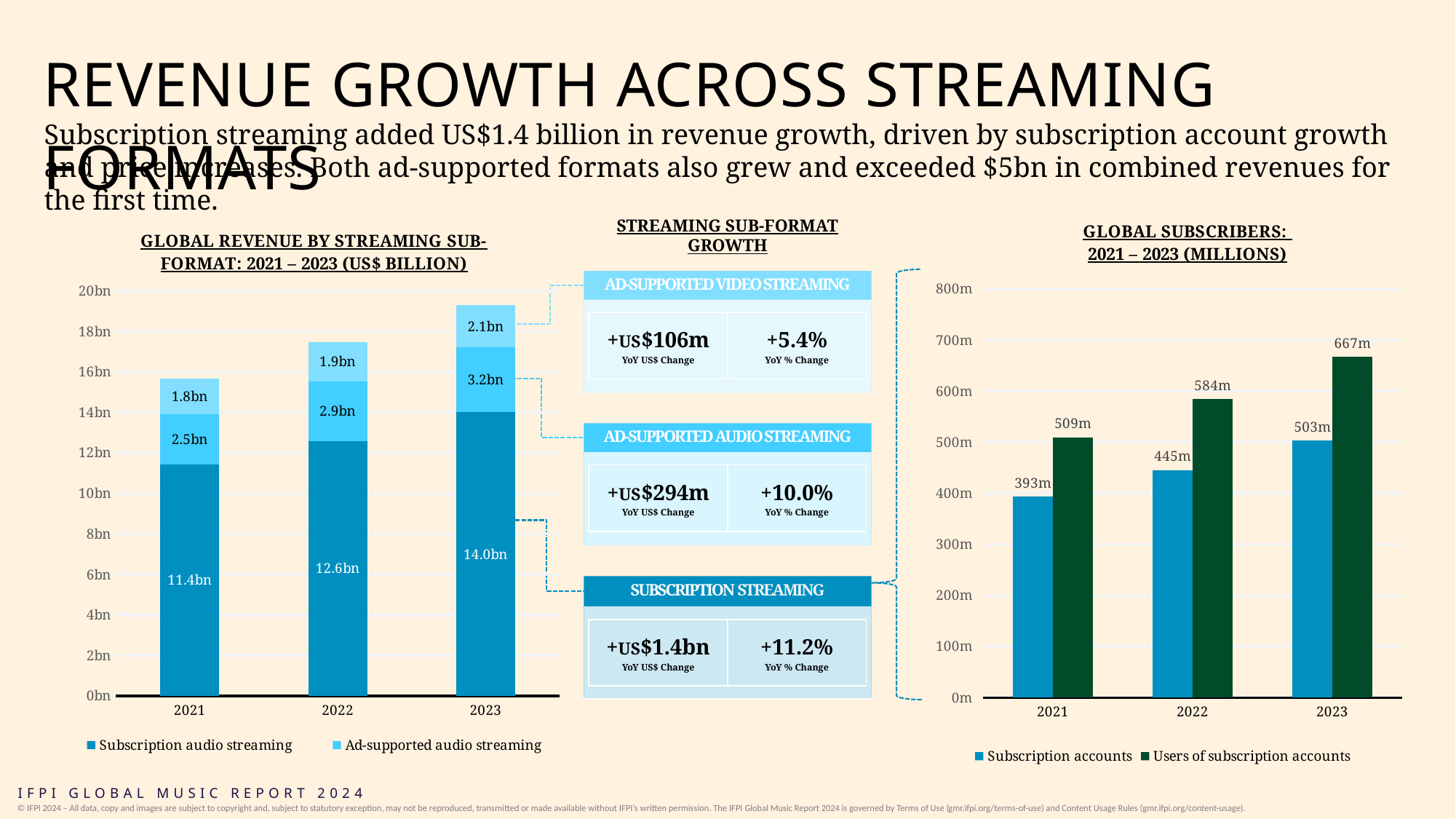
What kind of chart is the Global Subscribers chart? Bar chart In the Global Revenue by Streaming Sub-Format chart, how many years are shown on the x axis? 3 In the Global Subscribers chart, what is the value for users of subscription accounts in 2023? 667m In the Global Revenue by Streaming Sub-Format chart, what is the value of the ad-supported audio streaming segment for 2021? 2.5bn In the Global Subscribers chart, which is larger in 2021: subscription accounts or users of subscription accounts? Users of subscription accounts In the Global Subscribers chart, which year has the highest value for subscription accounts? 2023 In the Global Revenue by Streaming Sub-Format chart, what is the total of the stacked bar for 2022? 17.4bn In the Global Revenue by Streaming Sub-Format chart, does the subscription audio streaming segment rise or fall from 2021 to 2023? rise In the Global Revenue by Streaming Sub-Format chart, what is the difference between the subscription audio streaming values for 2023 and 2021? 2.6bn In the Global Subscribers chart, what is the value for subscription accounts in 2021? 393m In the Global Subscribers chart, what is the difference between users of subscription accounts and subscription accounts in 2022? 139m In the Global Revenue by Streaming Sub-Format chart, what is the value of the subscription audio streaming segment for 2023? 14.0bn